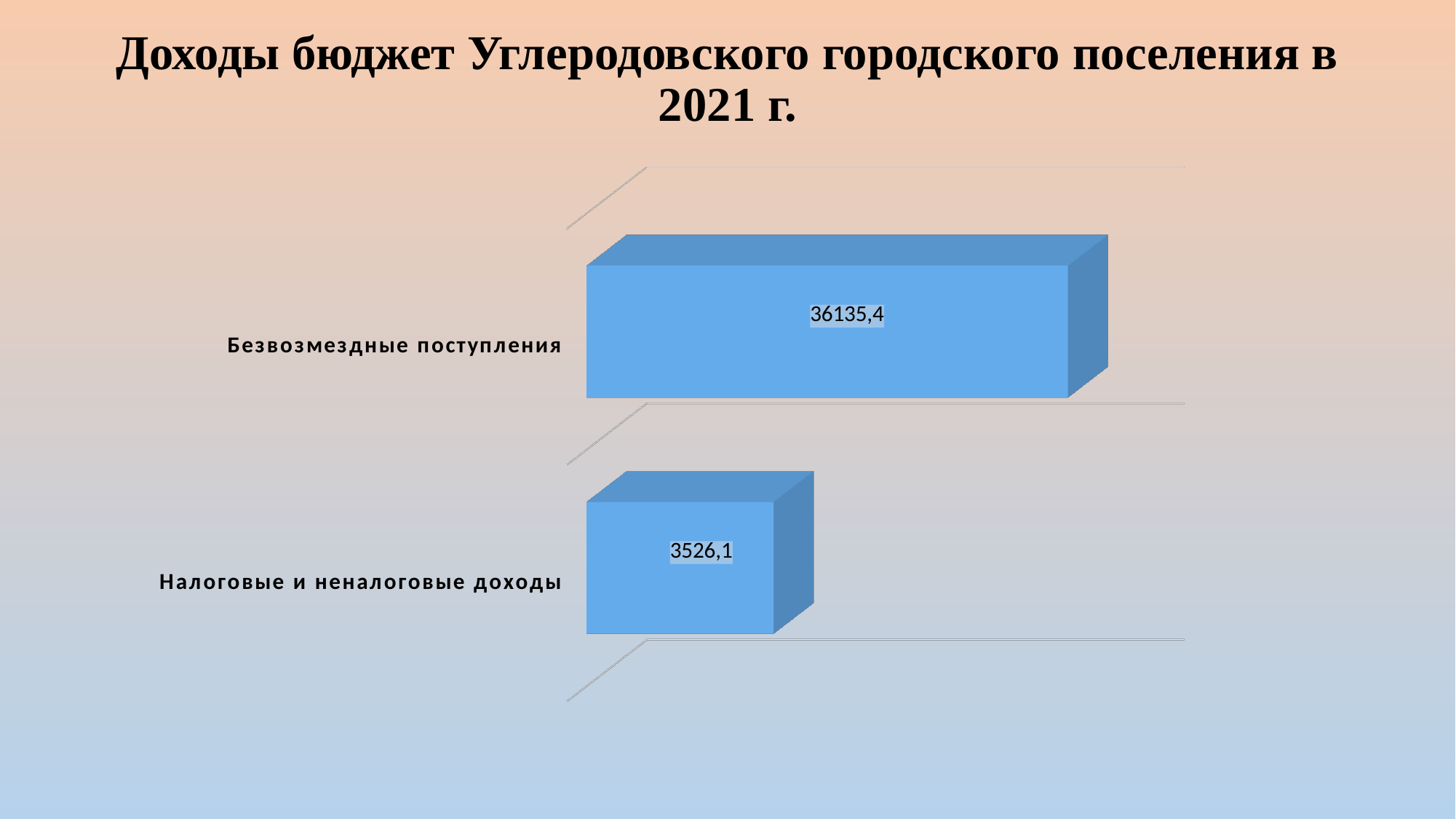
Which category has the highest value? Безвозмездные поступления How many categories are shown in the chart? 2 Which is larger: the value for Безвозмездные поступления or the value for Налоговые и неналоговые доходы? Безвозмездные поступления What is the title of the slide? Доходы бюджет Углеродовского городского поселения в 2021 г. What colour are the bars in the chart? Blue What kind of chart is shown on the slide? Bar chart What is the value for Безвозмездные поступления? 36135,4 What is the value for Налоговые и неналоговые доходы? 3526,1 Which category has the lowest value? Налоговые и неналоговые доходы What is the difference between the values for Безвозмездные поступления and Налоговые и неналоговые доходы? 32609,3 What is the sum of the two values shown in the chart? 39661,5